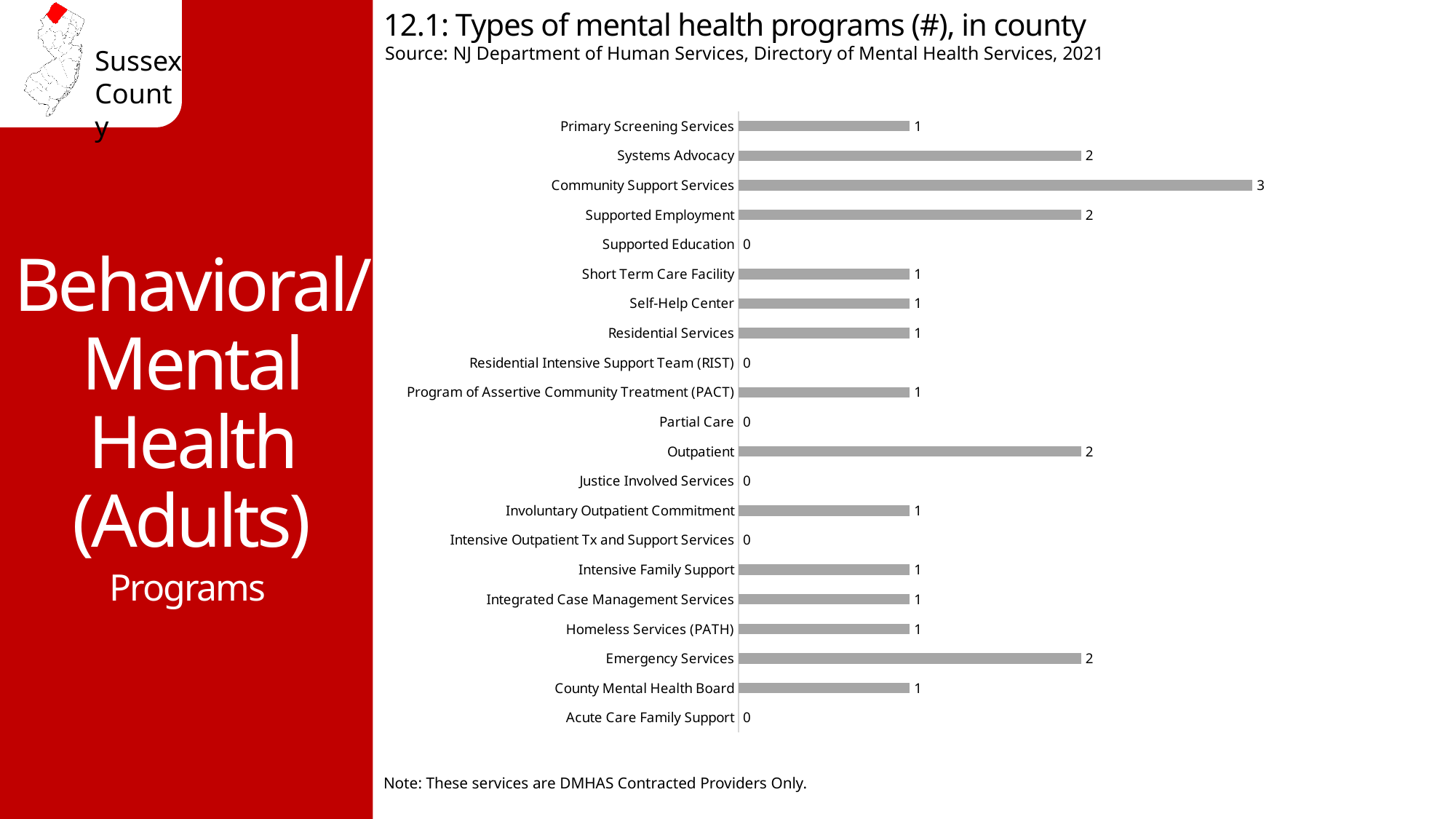
What is the value for Outpatient? 2 Which category has the highest value? Community Support Services What is the value for Homeless Services (PATH)? 1 What is the value for Partial Care? 0 Which is larger, Emergency Services or County Mental Health Board? Emergency Services How many categories are shown in the chart? 21 What is the title of the chart? 12.1: Types of mental health programs (#), in county What is the value for Community Support Services? 3 What is the difference between Community Support Services and Systems Advocacy? 1 How many categories have a value of 2? 4 What kind of chart is shown? Bar chart How many categories have a value of 0? 6